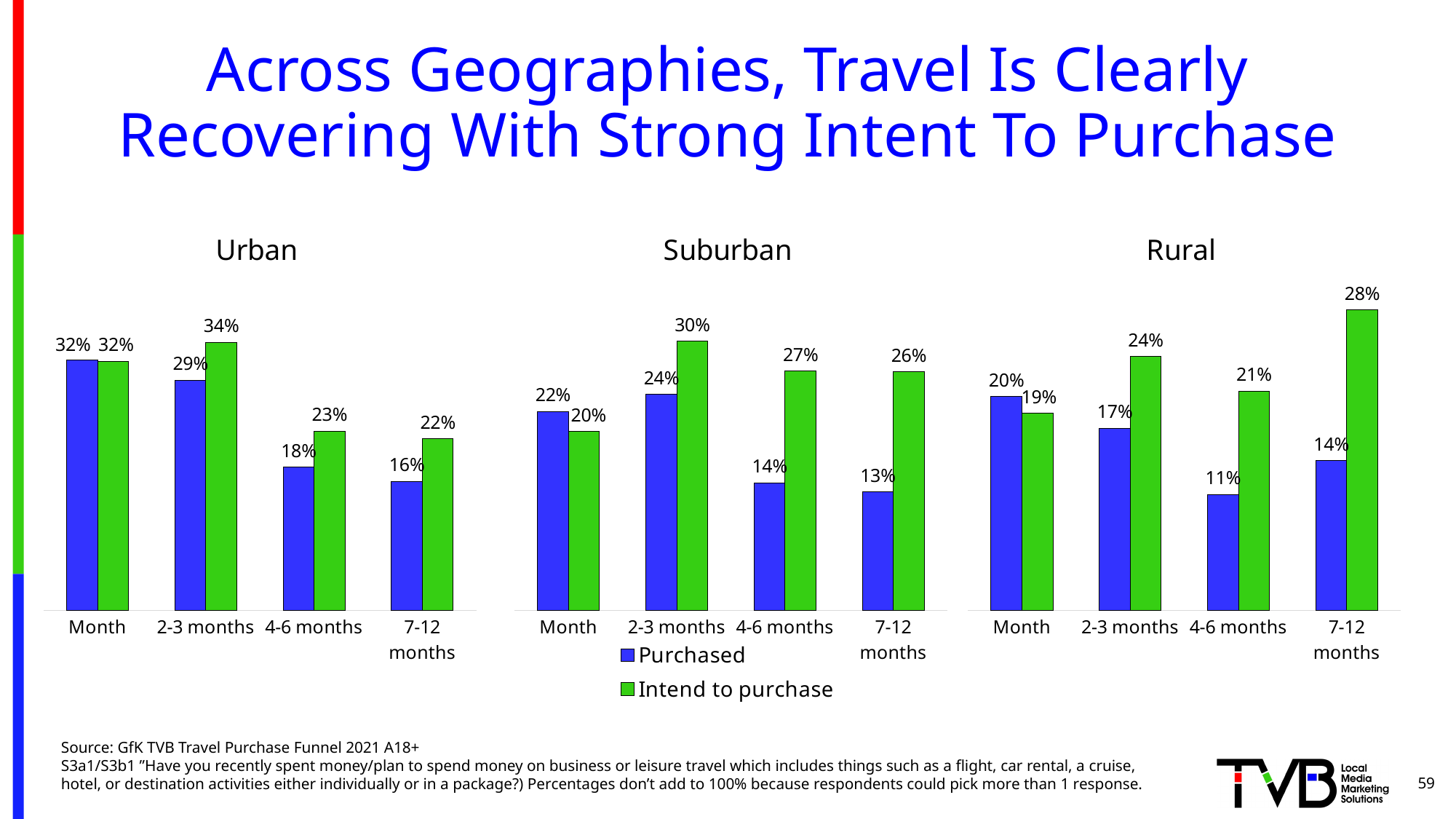
In the Suburban chart, which is larger for Month: Purchased or Intend to purchase? Purchased In the Rural chart, what is the Purchased value for 4-6 months? 11% In the Urban chart, what is the difference between Intend to purchase and Purchased for 7-12 months? 6% In the Rural chart, which category has the highest Intend to purchase value? 7-12 months Which colour represents Intend to purchase in the legend? green In the Urban chart, what is the Purchased value for 2-3 months? 29% In the Suburban chart, which category has the lowest Purchased value? 7-12 months What kind of chart is the Suburban chart? bar chart How many categories are shown on the x axis of the Urban chart? 4 In the Suburban chart, what is the Intend to purchase value for 4-6 months? 27% In the Rural chart, what is the difference between Intend to purchase and Purchased for 7-12 months? 14% How many series does the legend list? 2